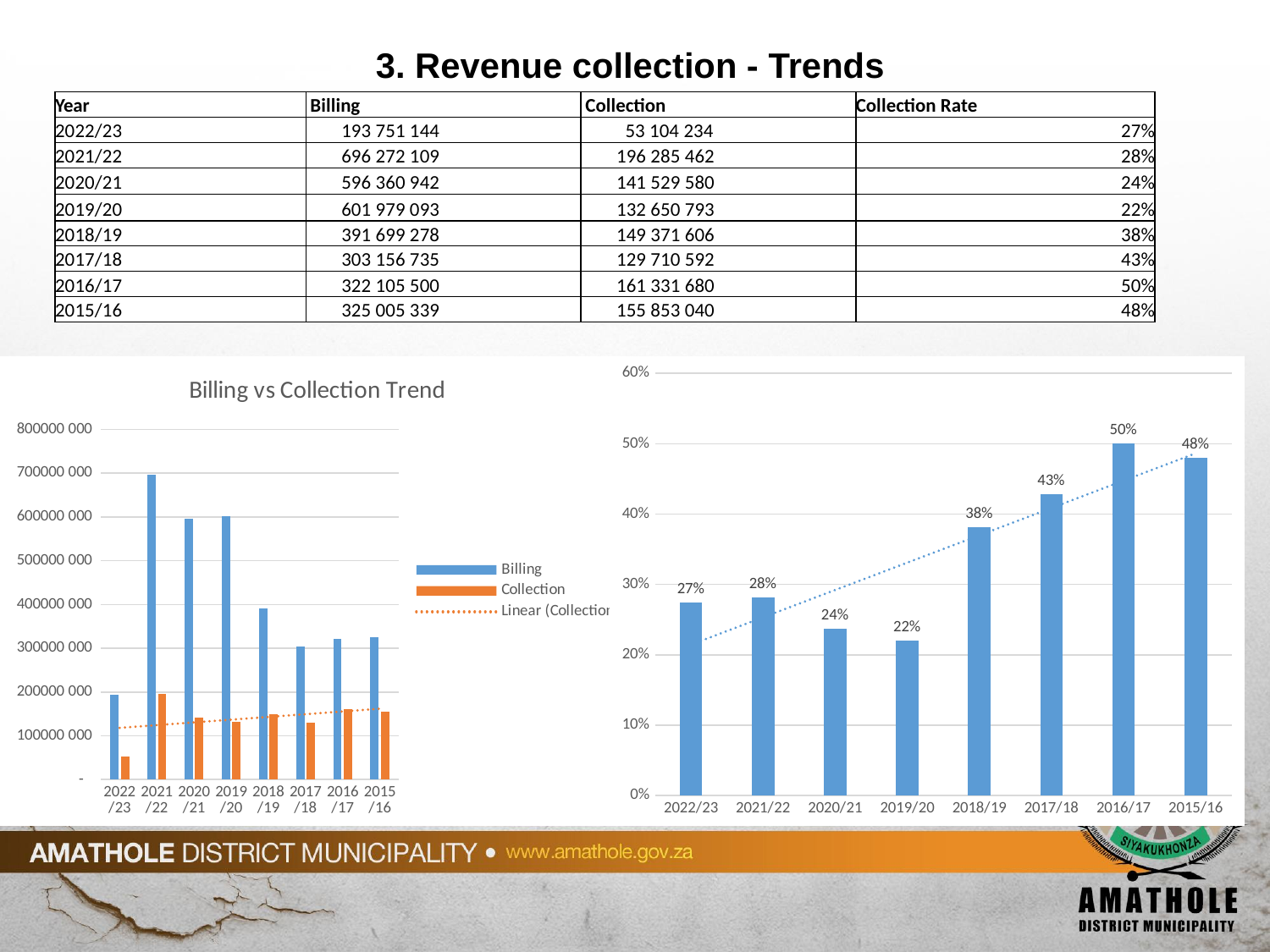
On the right-hand chart, do the collection rates generally rise or fall from 2022/23 on the left to 2015/16 on the right? rise On the right-hand chart, which year has the highest collection rate? 2016/17 On the right-hand chart, which year has the higher collection rate, 2017/18 or 2018/19? 2017/18 In the 'Billing vs Collection Trend' chart, is the Collection value for 2022/23 greater or less than 100000 000? less In the 'Billing vs Collection Trend' chart, is the Billing value for 2021/22 greater or less than 600000 000? greater On the right-hand chart, how many years are plotted? 8 On the right-hand chart, what is the difference between the collection rate for 2016/17 and for 2019/20? 28 percentage points In the 'Billing vs Collection Trend' chart, which year has the highest Billing bar? 2021/22 How many entries does the legend of the 'Billing vs Collection Trend' chart list? 3 On the right-hand chart, which year has the lowest collection rate? 2019/20 On the right-hand chart, what is the collection rate for 2018/19? 38% On the right-hand chart, what is the collection rate for 2019/20? 22%